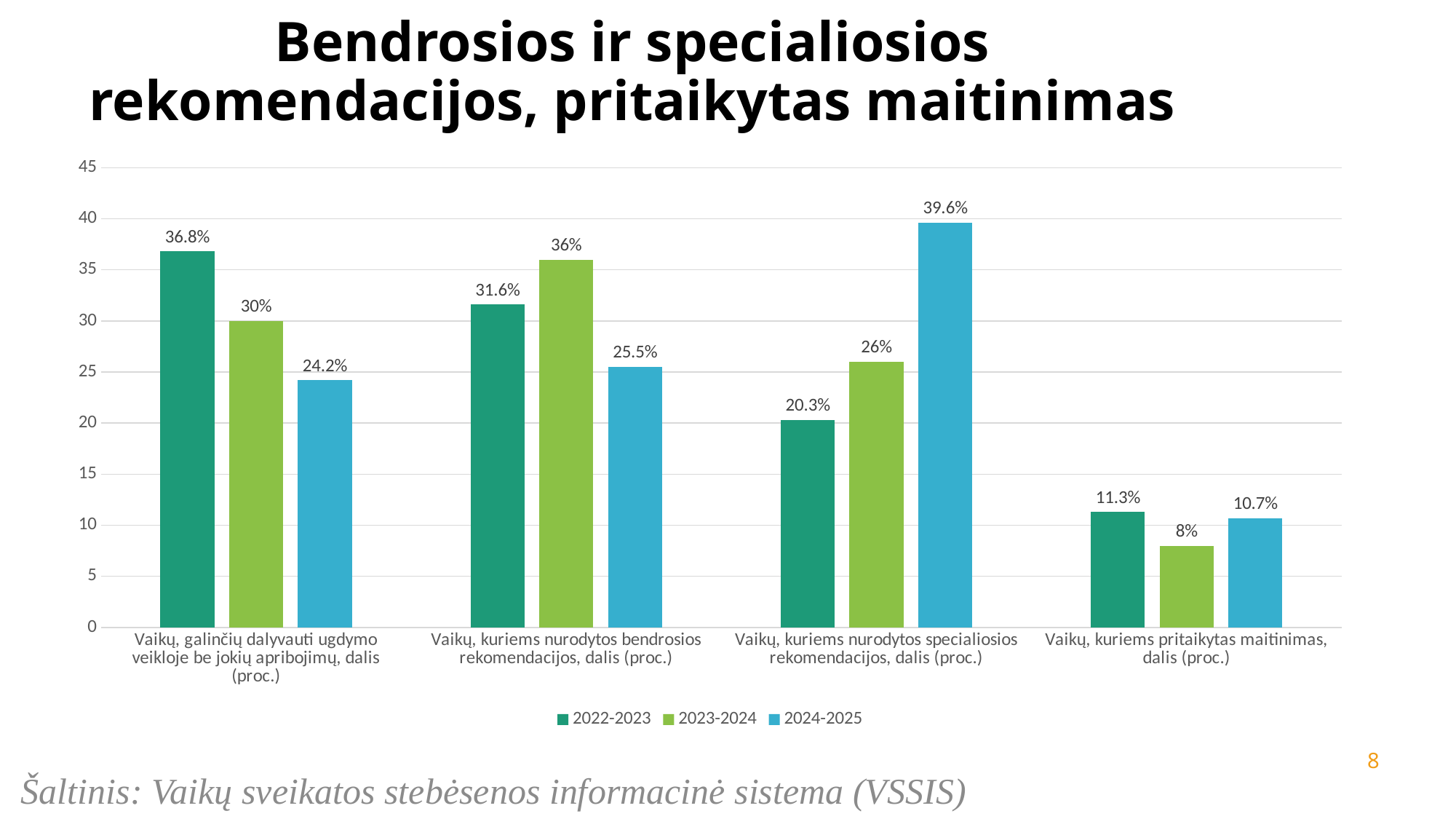
What is the difference between the 2022-2023 and 2024-2025 values in the category "Vaikų, galinčių dalyvauti ugdymo veikloje be jokių apribojimų, dalis (proc.)"? 12.6% How many categories are shown on the x axis? 4 What is the value for 2022-2023 in the category "Vaikų, galinčių dalyvauti ugdymo veikloje be jokių apribojimų, dalis (proc.)"? 36.8% What kind of chart is shown on the slide? bar chart Is the 2023-2024 value for "Vaikų, kuriems nurodytos specialiosios rekomendacijos, dalis (proc.)" greater or less than 25? greater What is the value for 2024-2025 in the category "Vaikų, kuriems nurodytos specialiosios rekomendacijos, dalis (proc.)"? 39.6% How many series does the legend list? 3 What is the value for 2023-2024 in the category "Vaikų, kuriems pritaikytas maitinimas, dalis (proc.)"? 8% Which is larger in the category "Vaikų, kuriems pritaikytas maitinimas, dalis (proc.)": the 2022-2023 value or the 2024-2025 value? 2022-2023 Which series has the lowest value in the category "Vaikų, galinčių dalyvauti ugdymo veikloje be jokių apribojimų, dalis (proc.)"? 2024-2025 Which series has the highest value in the category "Vaikų, kuriems nurodytos bendrosios rekomendacijos, dalis (proc.)"? 2023-2024 Do the values for "Vaikų, kuriems nurodytos specialiosios rekomendacijos, dalis (proc.)" rise or fall from 2022-2023 to 2024-2025? rise